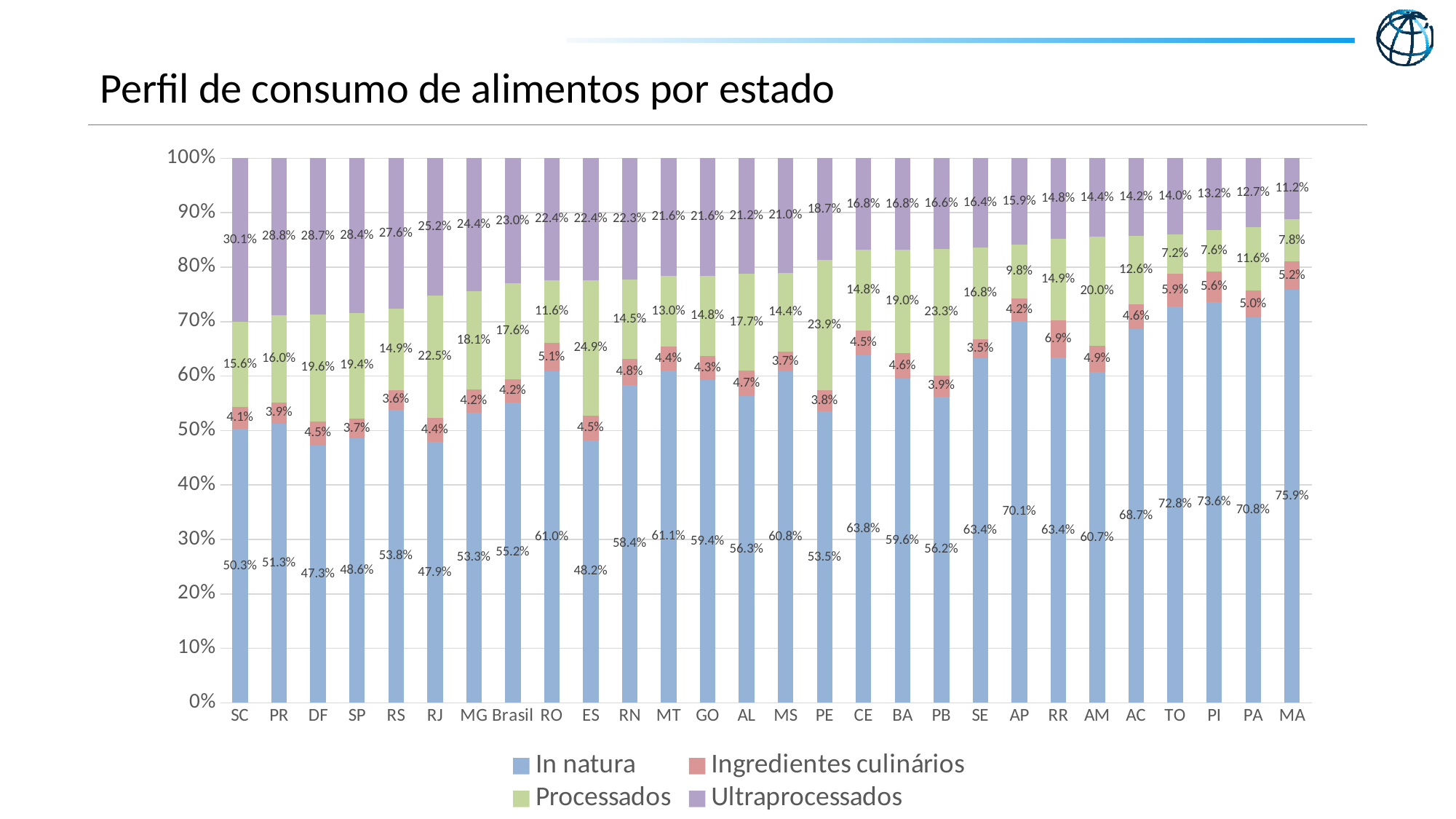
What is the Ultraprocessados share for SC? 30.1% Which state has the lowest In natura share? DF What is the difference between the Ultraprocessados share for SC and for MA? 18.9% Does the Ultraprocessados share rise or fall from left to right along the x axis? Fall Which has a larger Processados share, RJ or MG? RJ What kind of chart is shown on the slide? Stacked bar chart What is the Processados share for ES? 24.9% How many series does the legend list? 4 Which state has the highest In natura share? MA How many categories are shown on the x axis? 28 What is the Ingredientes culinários share for RR? 6.9% What is the In natura share for Brasil? 55.2%